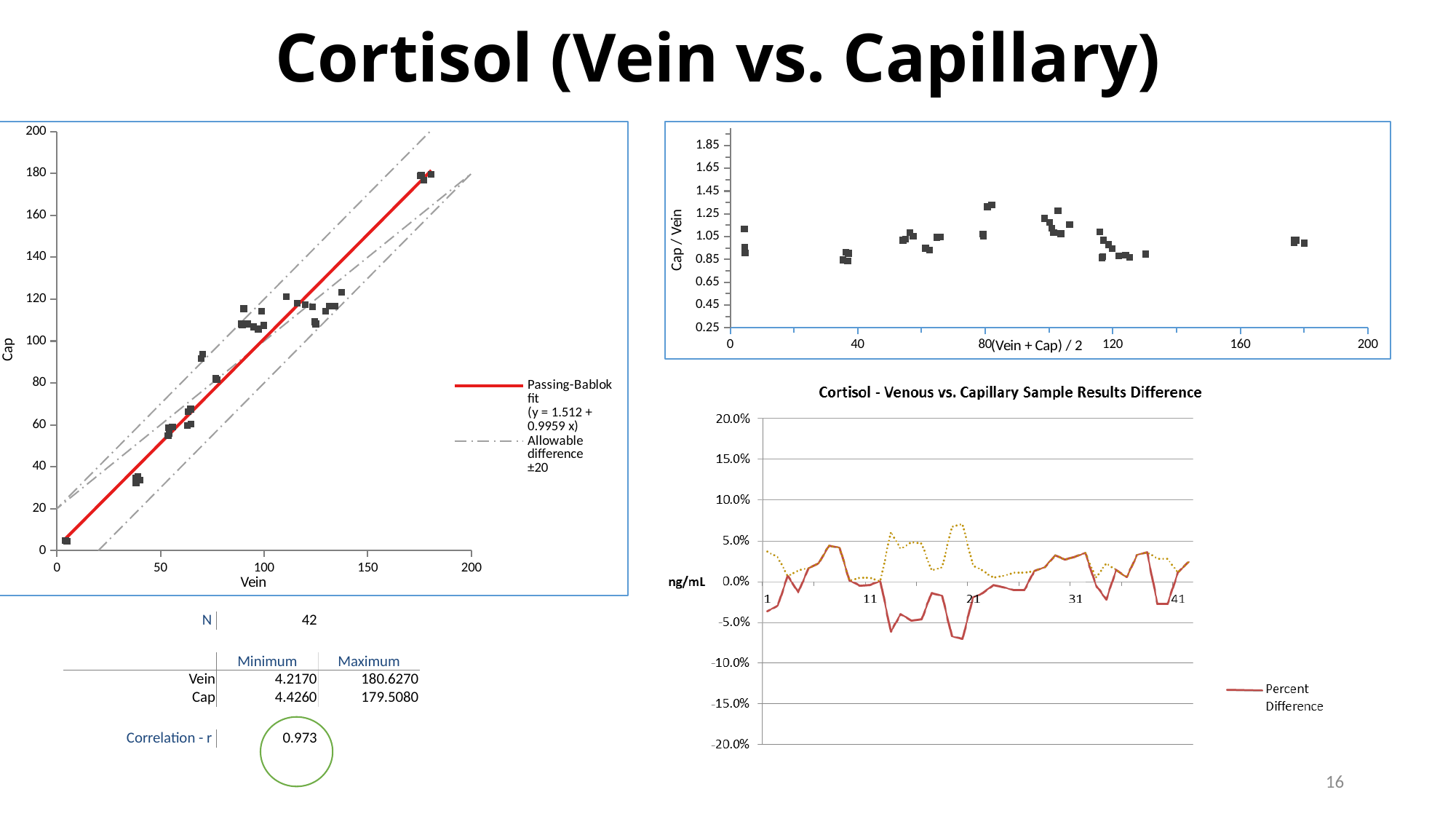
In the bottom-right 'Cortisol - Venous vs. Capillary Sample Results Difference' chart, is the lowest value of the Percent Difference line greater or less than -5.0%? less In the top-right Cap / Vein ratio chart, is the highest ratio plotted greater or less than 1.25? greater What kind of chart is the bottom-right 'Cortisol - Venous vs. Capillary Sample Results Difference' chart? line chart According to the table below the left chart, how many samples (N) are included? 42 In the top-right Cap / Vein ratio chart, is the lowest ratio plotted greater or less than 0.65? greater How many series does the legend of the left Cap vs. Vein chart list? 2 What is the title of the bottom-right line chart? Cortisol - Venous vs. Capillary Sample Results Difference In the left Cap vs. Vein chart, do the Cap values rise or fall as Vein increases? rise How many series does the legend of the bottom-right 'Cortisol - Venous vs. Capillary Sample Results Difference' chart list? 1 In the left Cap vs. Vein chart, what equation is given for the Passing-Bablok fit? y = 1.512 + 0.9959 x What kind of chart is the left chart plotting Cap against Vein? scatter chart